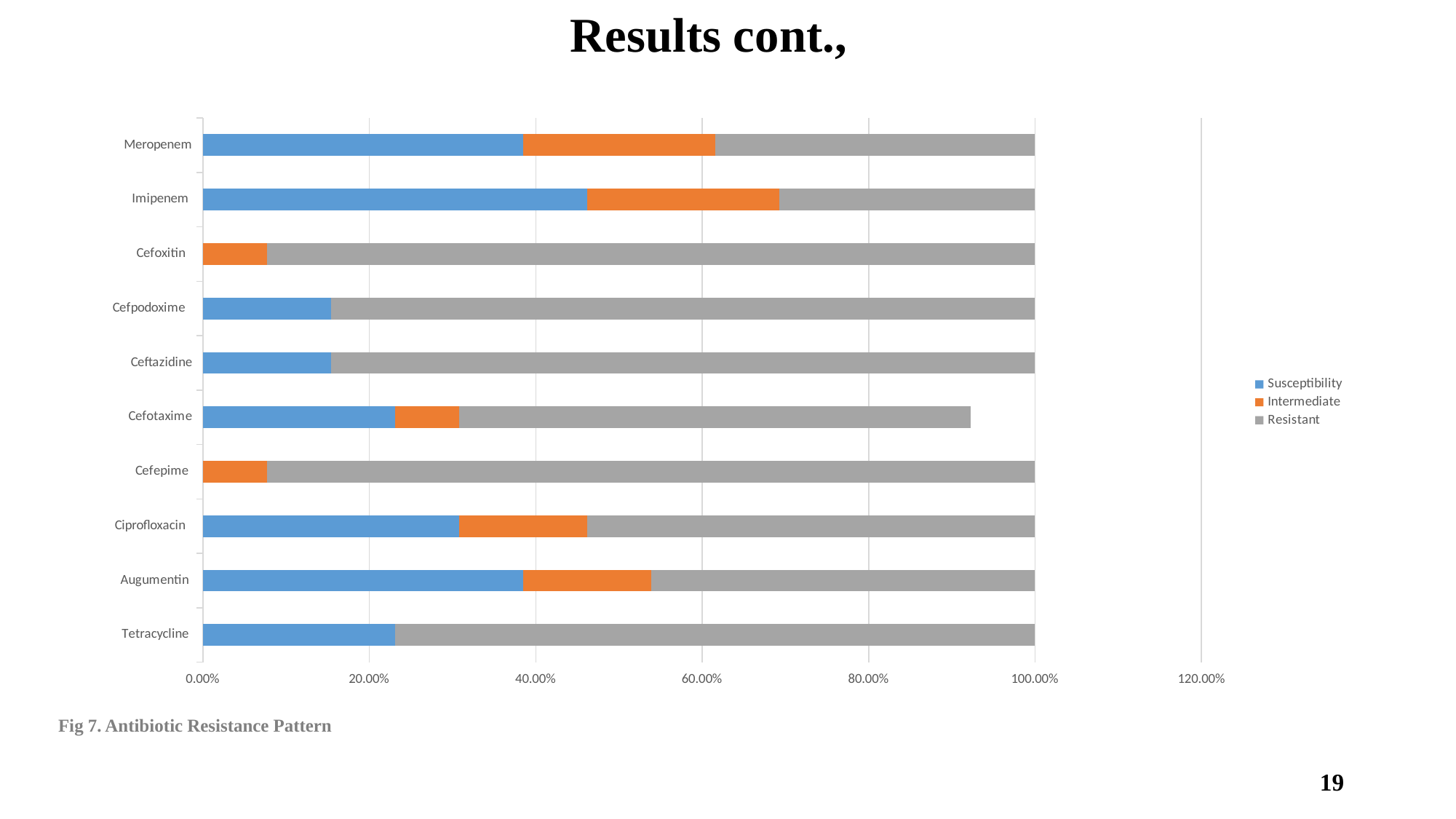
What are the three series named in the legend? Susceptibility, Intermediate, Resistant Is the Intermediate value for Cefoxitin greater or less than 20.00%? less Which has the larger Susceptibility segment, Ciprofloxacin or Tetracycline? Ciprofloxacin How many series does the chart's legend list? 3 Which has the larger Resistant segment, Cefoxitin or Meropenem? Cefoxitin What kind of chart is shown on the slide? Stacked bar chart Is the Susceptibility value for Imipenem greater or less than 40.00%? greater Is the total length of the Cefotaxime bar greater or less than 100.00%? less How many antibiotics are listed on the vertical axis of the chart? 10 What is the figure caption below the chart? Fig 7. Antibiotic Resistance Pattern Which antibiotic has the largest Susceptibility segment? Imipenem